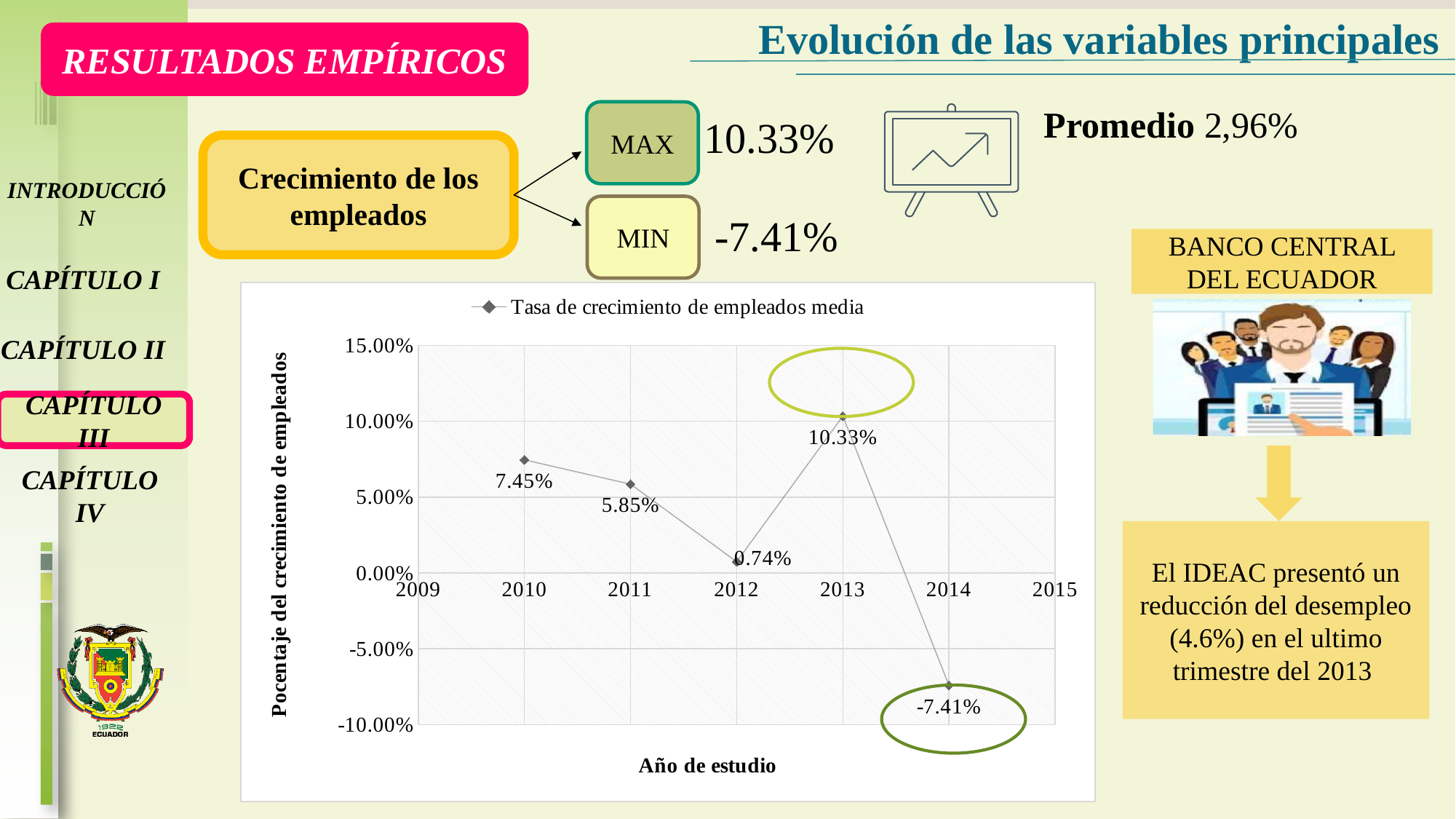
What is the difference between the values for 2013 and 2011? 4.48% What is the value for 2012 in the chart? 0.74% How many data points are plotted in the chart? 5 What is the series name shown in the chart legend? Tasa de crecimiento de empleados media Which is larger, the value for 2010 or the value for 2011? 2010 How many series does the chart legend list? 1 What is the value for 2010 in the chart? 7.45% What is the value for 2014 in the chart? -7.41% What type of chart is shown on the slide? Line chart Which year has the lowest value in the chart? 2014 Which year has the highest value in the chart? 2013 Is the value for 2013 greater or less than 10.00%? greater